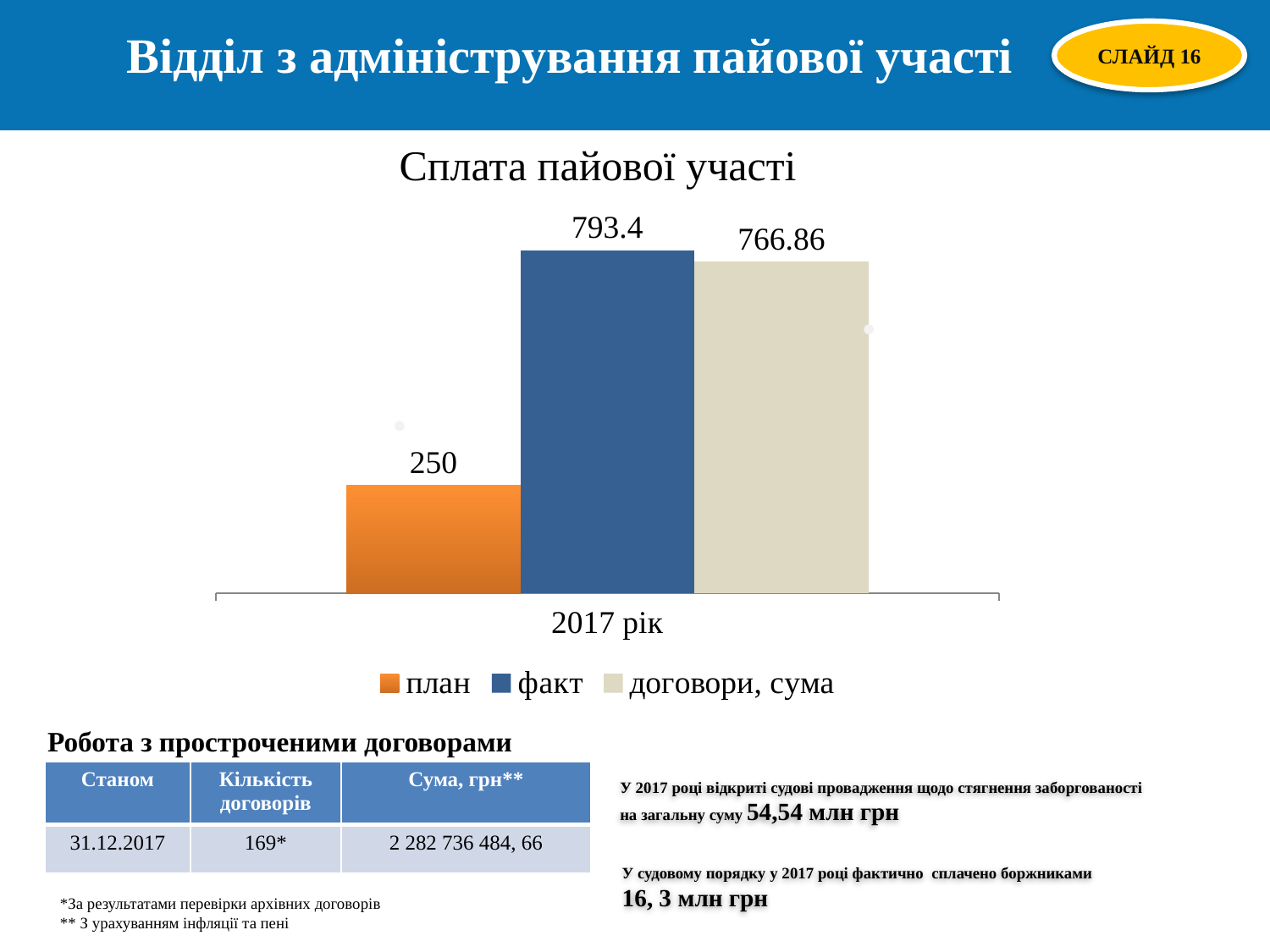
How many categories are shown on the x axis of the chart? 1 Which series has the lowest value for 2017 рік? план What is the value of the 'договори, сума' series for 2017 рік? 766.86 What is the title of the chart? Сплата пайової участі What is the value of the 'план' series for 2017 рік? 250 Which series has the highest value for 2017 рік? факт What is the difference between the 'факт' and 'договори, сума' values for 2017 рік? 26.54 What type of chart is shown on the slide? bar chart Which is larger for 2017 рік: 'план' or 'договори, сума'? договори, сума What is the value of the 'факт' series for 2017 рік? 793.4 What is the difference between the 'факт' and 'план' values for 2017 рік? 543.4 How many series does the legend list? 3